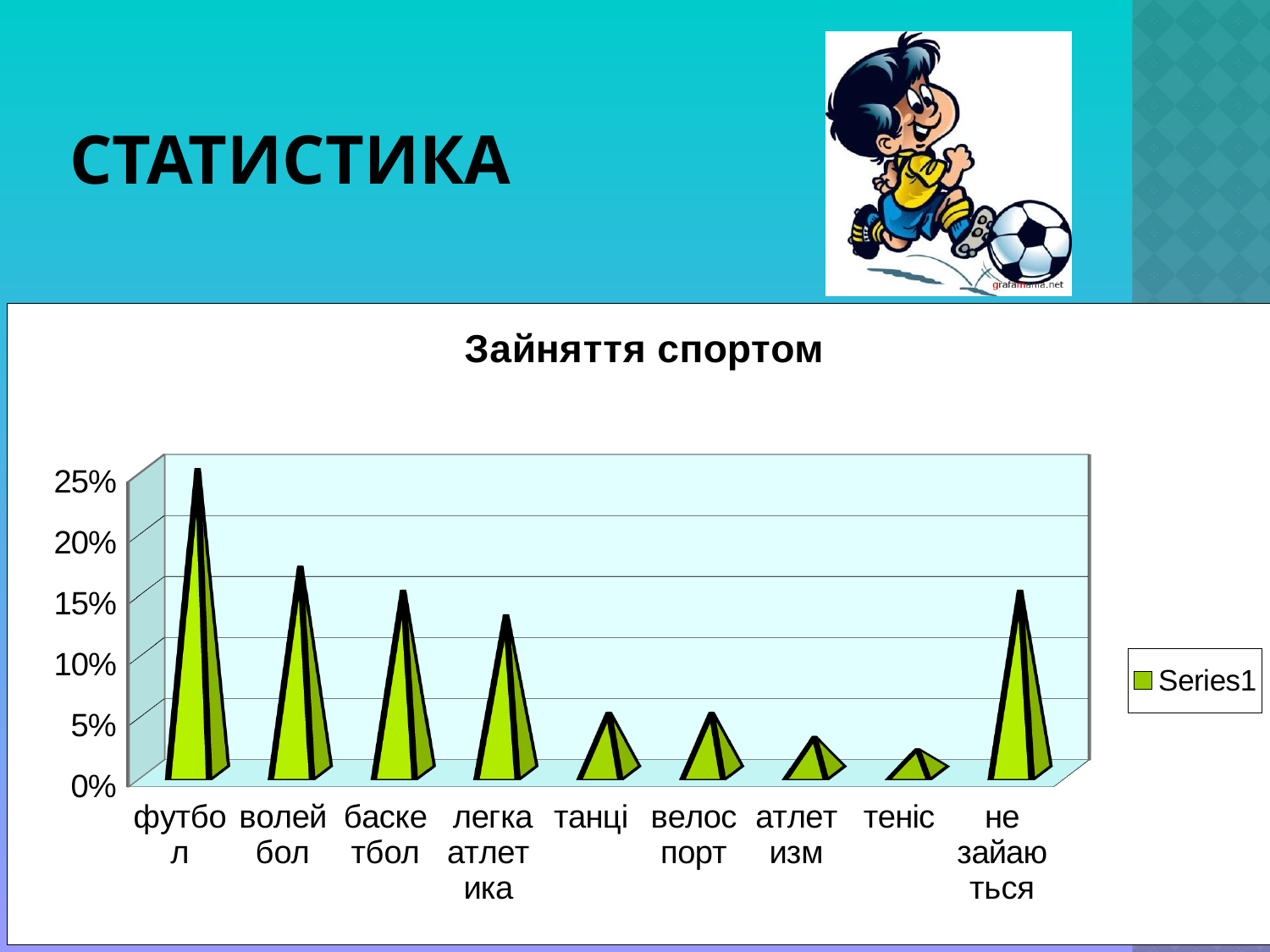
How many series does the chart legend list? 1 What kind of chart is shown on the slide? bar chart Is the value for футбол greater or less than 20%? greater What is the title of the chart? Зайняття спортом Which is larger, the value for футбол or the value for волейбол? футбол Which category has the lowest value in the chart? теніс Is the value for не займаються greater or less than 10%? greater Which category has the highest value in the chart? футбол Which is larger, the value for легка атлетика or the value for атлетизм? легка атлетика How many categories are shown on the x axis of the chart? 9 Is the value for теніс greater or less than 5%? less